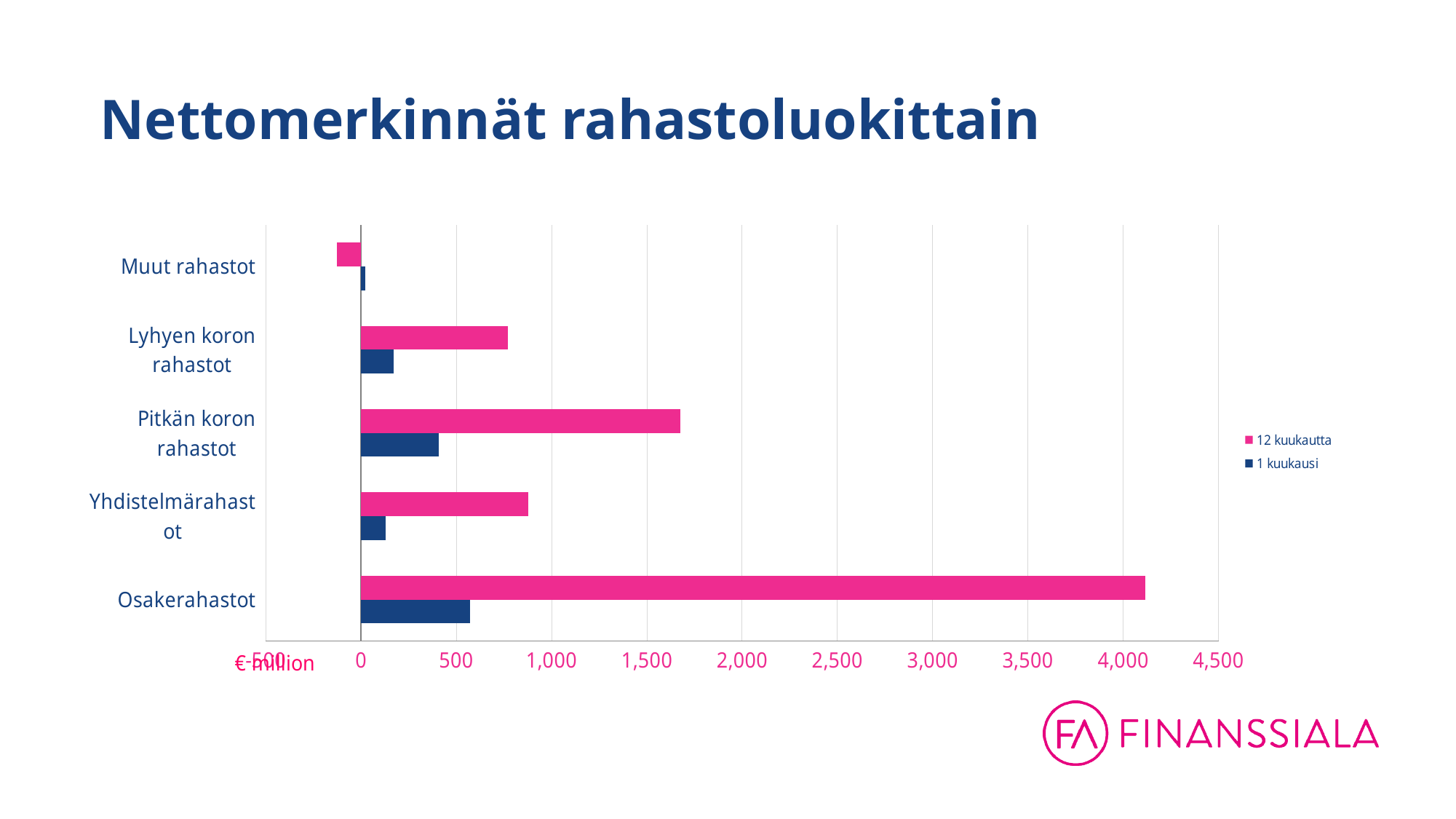
Is the 1 kuukausi value for Pitkän koron rahastot greater or less than 500? less Which category has the highest value for the 12 kuukautta series? Osakerahastot Which category has the lowest value for the 12 kuukautta series? Muut rahastot Is the 12 kuukautta value for Pitkän koron rahastot greater or less than 1,500? greater How many fund categories are shown on the chart? 5 What kind of chart is shown on the slide? bar chart Is the 12 kuukautta value for Muut rahastot greater or less than 0? less What is the title of the chart? Nettomerkinnät rahastoluokittain How many series does the legend list? 2 For the 12 kuukautta series, which is larger: Pitkän koron rahastot or Lyhyen koron rahastot? Pitkän koron rahastot Which colour represents the 1 kuukausi series? dark blue